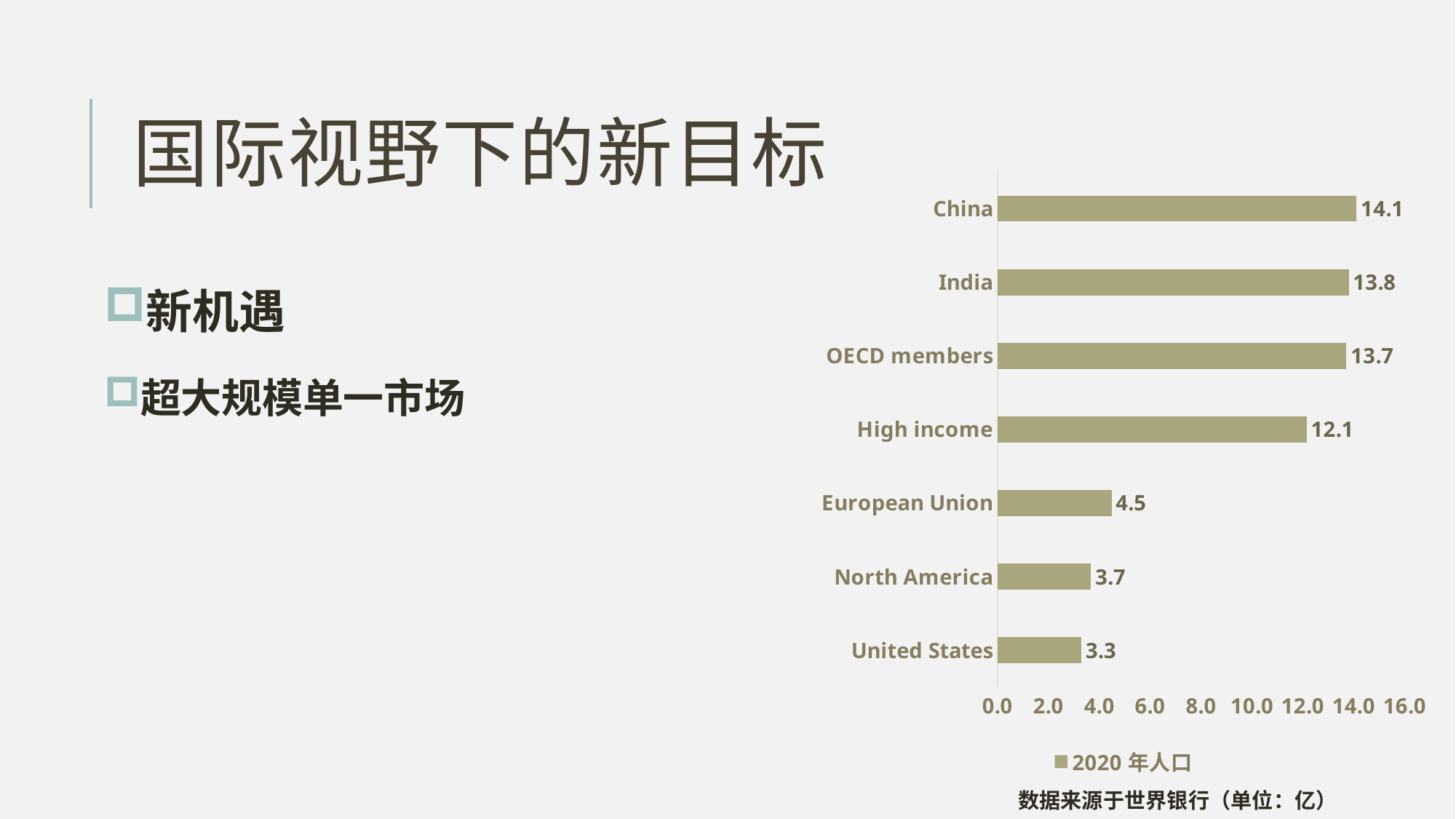
Which category has the lowest value in the chart? United States How many categories are shown in the chart? 7 What is the 2020 population value shown for China? 14.1 What is the legend entry for the series in the chart? 2020 年人口 Which is larger, the value for OECD members or the value for High income? OECD members What is the value shown for North America? 3.7 What is the difference between the values for High income and European Union? 7.6 Which category has the highest value in the chart? China How many series does the legend list? 1 What is the difference between the values for China and India? 0.3 What is the value shown for the European Union? 4.5 What kind of chart is shown on the slide? Bar chart